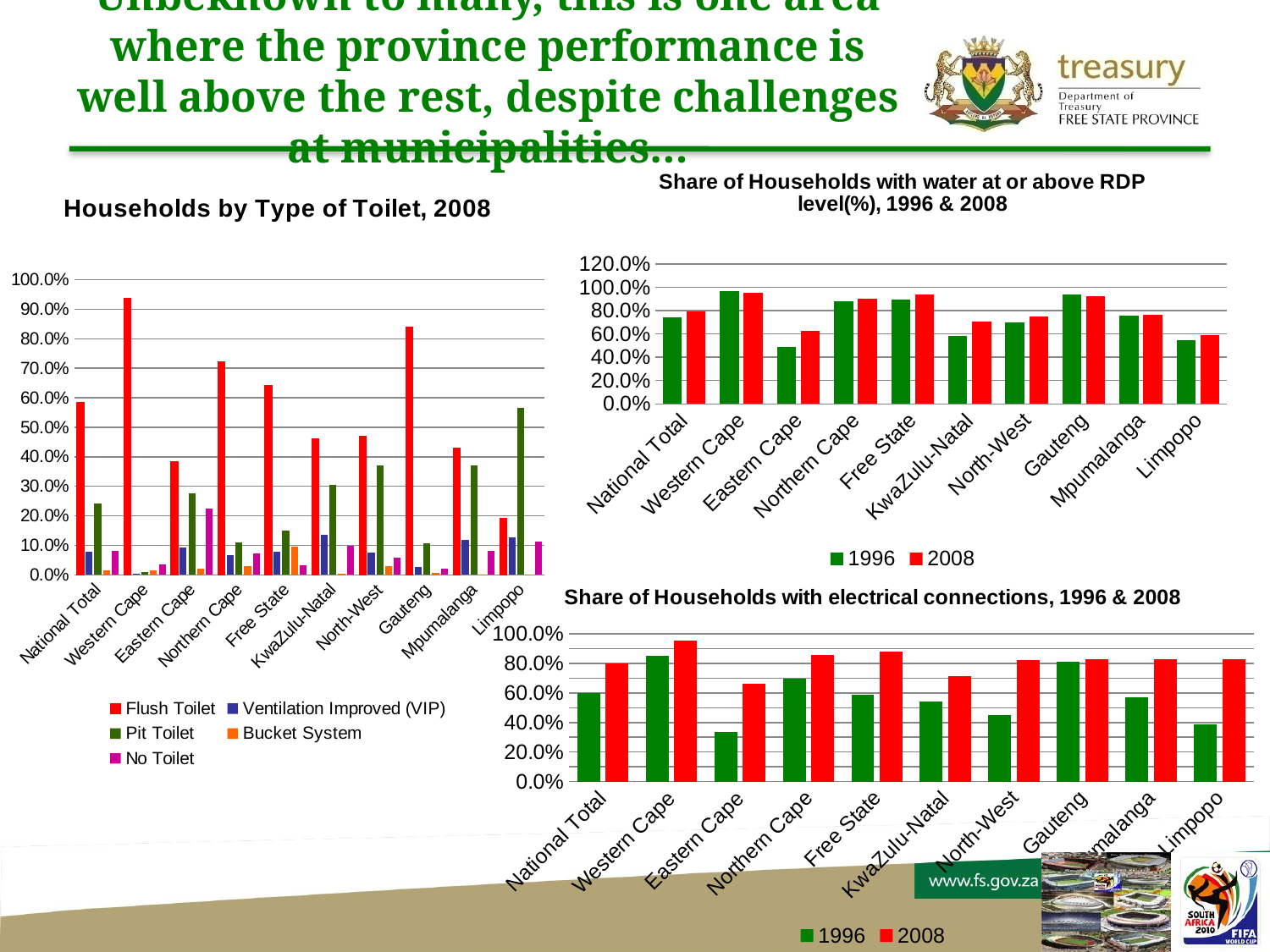
In the 'Share of Households with electrical connections, 1996 & 2008' chart, which category has the lowest 1996 value? Eastern Cape In the 'Share of Households with water at or above RDP level(%), 1996 & 2008' chart, is the 1996 value for Free State greater or less than 80%? greater In the 'Share of Households with water at or above RDP level(%), 1996 & 2008' chart, which category has the highest 1996 value? Western Cape In the 'Households by Type of Toilet, 2008' chart, which province has the highest Flush Toilet share? Western Cape In the 'Households by Type of Toilet, 2008' chart, which province has the highest No Toilet share? Eastern Cape In the 'Households by Type of Toilet, 2008' chart, is the Flush Toilet value for Gauteng greater or less than 80%? greater In the 'Share of Households with electrical connections, 1996 & 2008' chart, is the 2008 value for Free State larger or smaller than the 1996 value for Free State? larger What type of chart is the 'Share of Households with electrical connections, 1996 & 2008' chart? bar chart In the 'Share of Households with water at or above RDP level(%), 1996 & 2008' chart, which category has the lowest 1996 value? Eastern Cape In the 'Households by Type of Toilet, 2008' chart, how many series does the legend list? 5 How many categories are shown on the x axis of the 'Share of Households with water at or above RDP level(%), 1996 & 2008' chart? 10